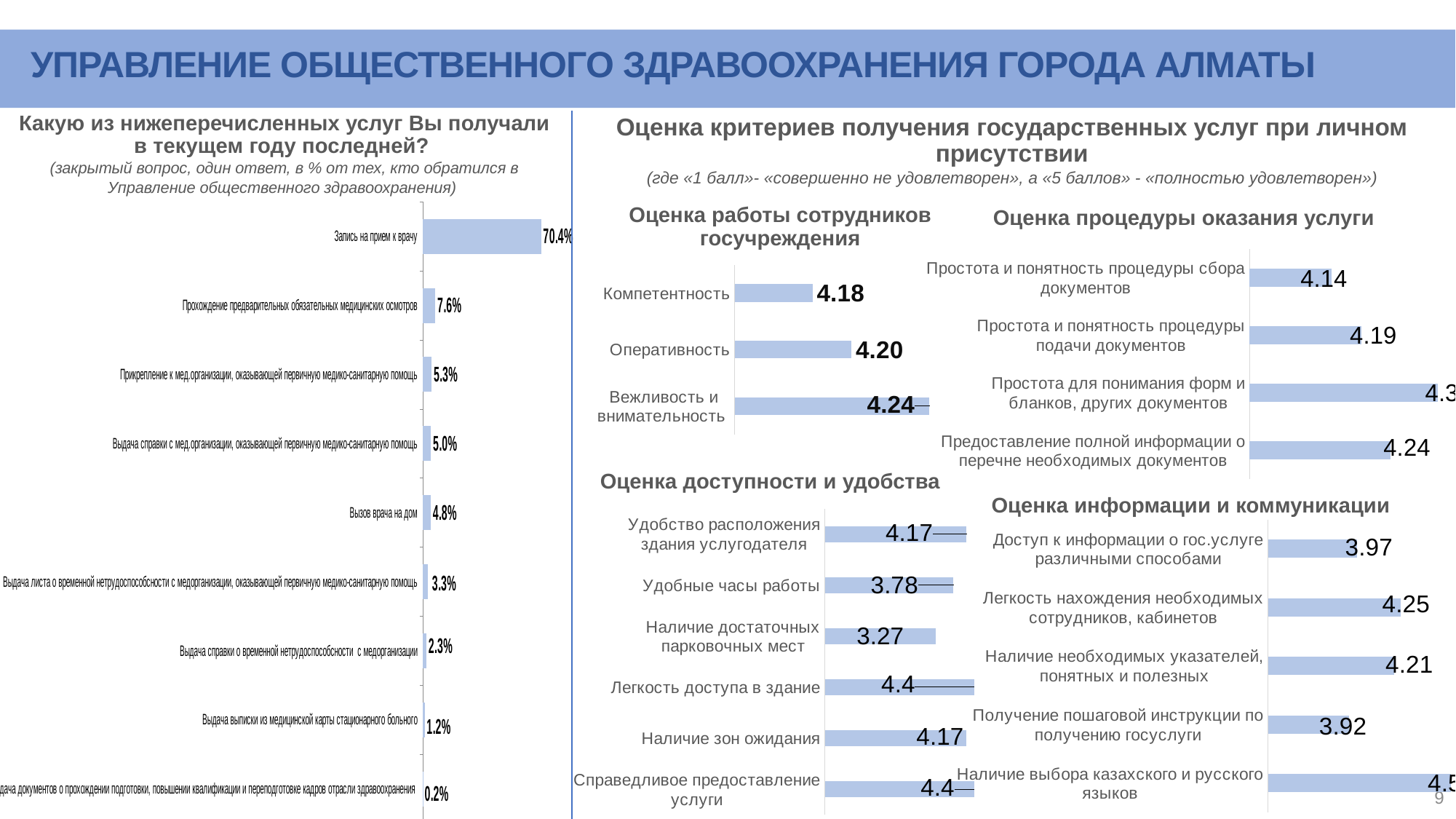
In the chart 'Оценка доступности и удобства', which is higher: 'Удобные часы работы' or 'Легкость доступа в здание'? Легкость доступа в здание In the chart 'Оценка процедуры оказания услуги', what is the difference between 'Предоставление полной информации о перечне необходимых документов' and 'Простота и понятность процедуры сбора документов'? 0.10 In the chart 'Оценка процедуры оказания услуги', what is the score for 'Простота и понятность процедуры подачи документов'? 4.19 What type of chart is 'Оценка информации и коммуникации'? Bar chart In the chart 'Оценка работы сотрудников госучреждения', which criterion has the lowest score? Компетентность In the chart 'Какую из нижеперечисленных услуг Вы получали в текущем году последней?', what is the value for 'Вызов врача на дом'? 4.8% In the chart 'Какую из нижеперечисленных услуг Вы получали в текущем году последней?', what is the value for 'Запись на прием к врачу'? 70.4% In the chart 'Оценка информации и коммуникации', what is the score for 'Получение пошаговой инструкции по получению госуслуги'? 3.92 In the chart 'Оценка работы сотрудников госучреждения', how many criteria are shown? 3 In the chart 'Оценка работы сотрудников госучреждения', what is the score for 'Оперативность'? 4.20 In the chart 'Какую из нижеперечисленных услуг Вы получали в текущем году последней?', which category has the highest value? Запись на прием к врачу In the chart 'Оценка доступности и удобства', what is the score for 'Наличие достаточных парковочных мест'? 3.27